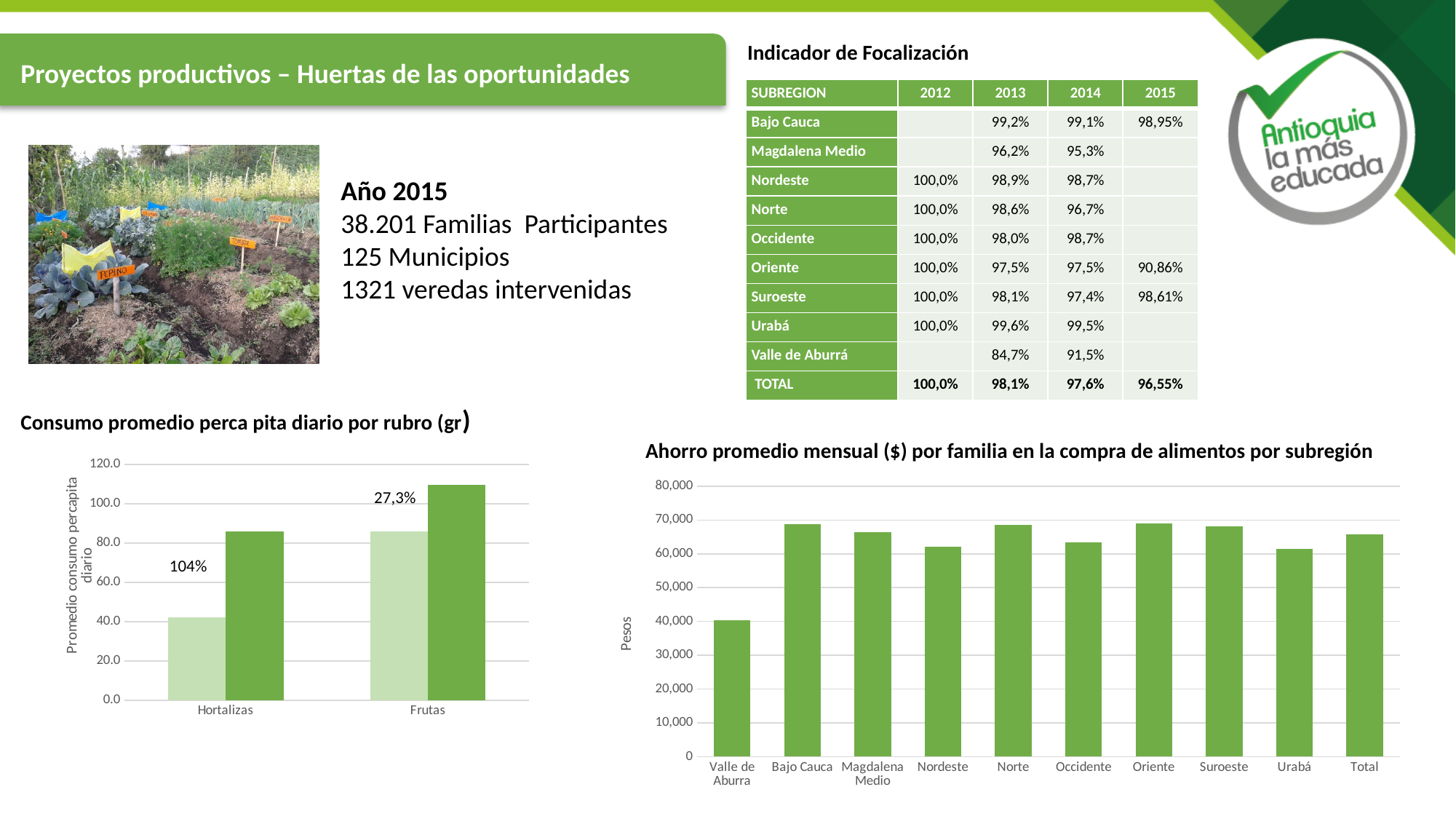
In the 'Consumo promedio perca pita diario por rubro (gr)' chart, what percentage label is printed above the Hortalizas bars? 104% In the 'Consumo promedio perca pita diario por rubro (gr)' chart, how many categories are shown on the x axis? 2 In the 'Ahorro promedio mensual' chart, which is larger, the value for Norte or the value for Urabá? Norte In the 'Consumo promedio perca pita diario por rubro (gr)' chart, is the dark green bar for Frutas greater or less than 100.0? greater What kind of chart is the 'Ahorro promedio mensual ($) por familia en la compra de alimentos por subregión' chart? bar chart In the 'Ahorro promedio mensual' chart, is the value for Valle de Aburra greater or less than 50,000? less In the 'Ahorro promedio mensual' chart, what is the label on the vertical axis? Pesos What kind of chart is the 'Consumo promedio perca pita diario por rubro (gr)' chart? bar chart In the 'Ahorro promedio mensual' chart, how many categories are shown on the x axis? 10 In the 'Ahorro promedio mensual' chart, which subregion has the lowest value? Valle de Aburra In the 'Consumo promedio perca pita diario por rubro (gr)' chart, is the light green bar for Hortalizas greater or less than 60.0? less